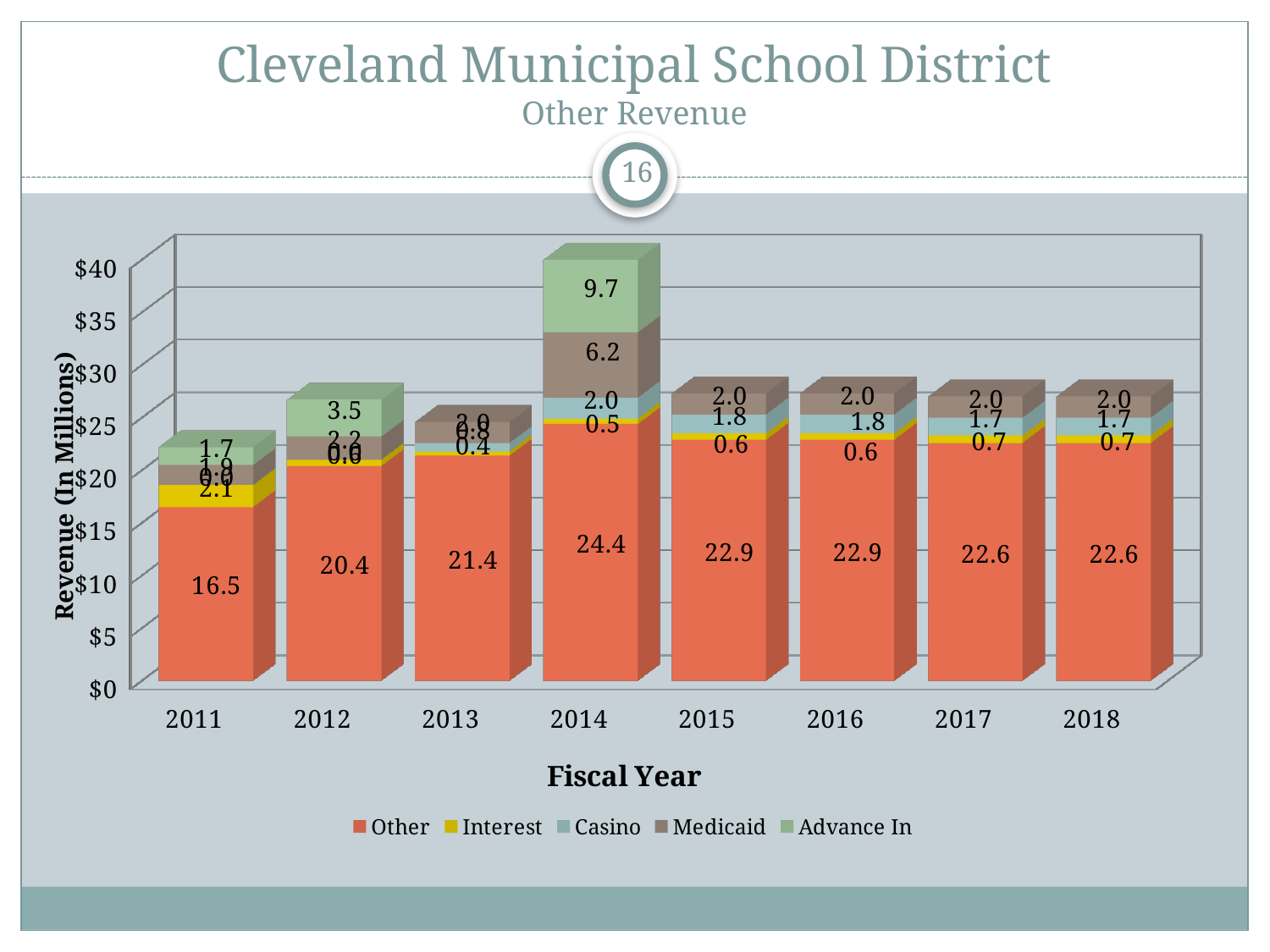
What is the value of the Other series for fiscal year 2011? 16.5 What is the value of the Advance In series for fiscal year 2014? 9.7 What is the value of the Interest series for fiscal year 2017? 0.7 What is the value of the Medicaid series for fiscal year 2014? 6.2 How many series does the legend list? 5 How many fiscal years are shown on the x axis? 8 What type of chart is shown on the slide? stacked bar chart Which is larger, the Casino value in 2015 or the Casino value in 2017? 2015 Which fiscal year has the lowest value for the Other series? 2011 What is the difference between the Other value in 2014 and the Other value in 2011? 7.9 What is the total of the stacked bar for fiscal year 2014? 42.8 Which fiscal year has the highest value for the Other series? 2014